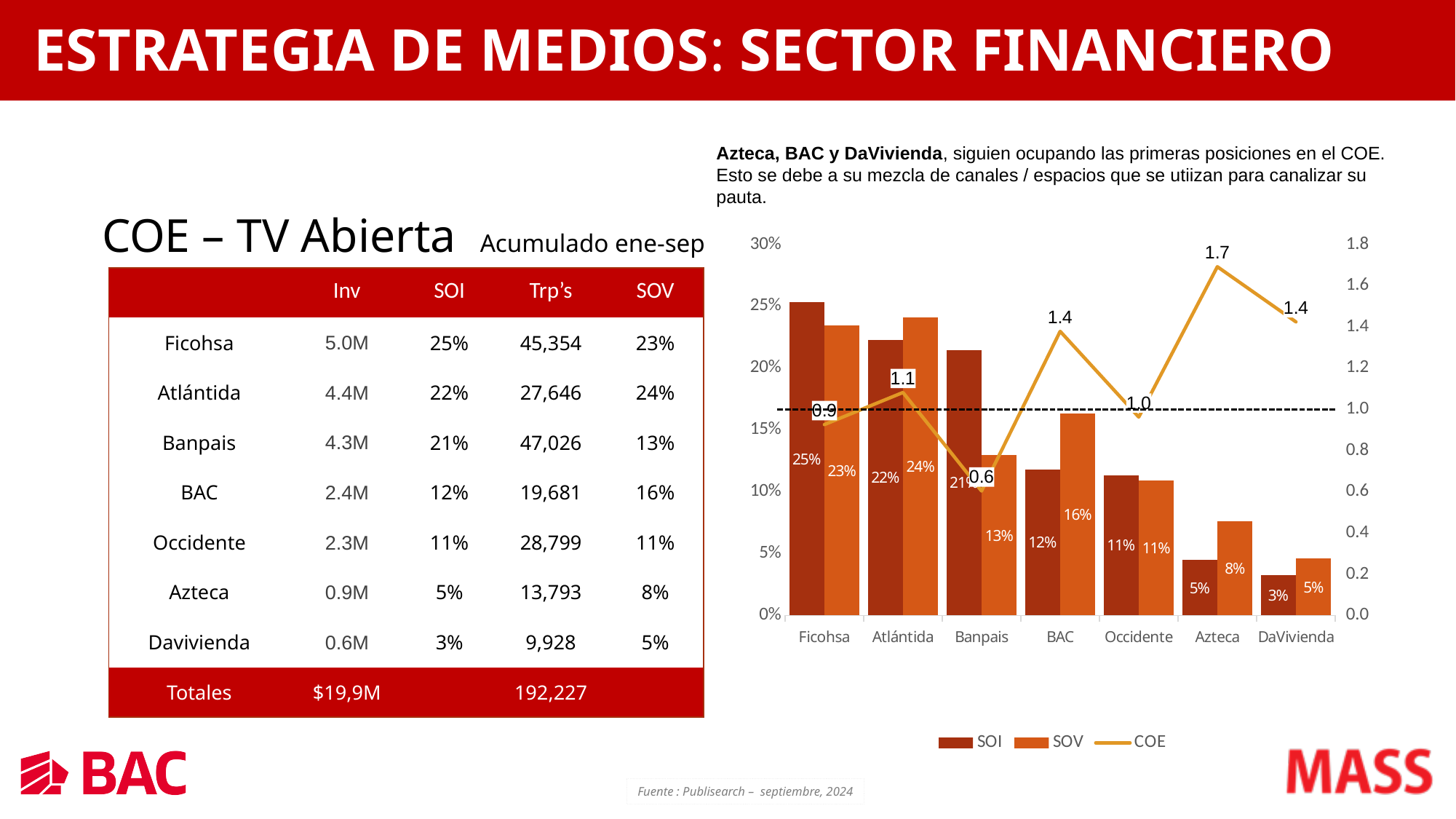
How many series does the chart legend list? 3 Which category has the highest COE value in the chart? Azteca What is the COE value for Azteca in the chart? 1.7 What kind of chart is shown on the slide? A bar chart combined with a line chart What is the difference between the SOV and SOI values for BAC in the chart? 4 percentage points For Atlántida, which is larger in the chart: SOI or SOV? SOV What is the SOI value for Ficohsa in the chart? 25% Which category has the lowest COE value in the chart? Banpais Which category has the highest SOV value in the chart? Atlántida What is the SOV value for BAC in the chart? 16% Is the COE value for BAC greater or less than 1.0? greater How many categories are shown on the x axis of the chart? 7